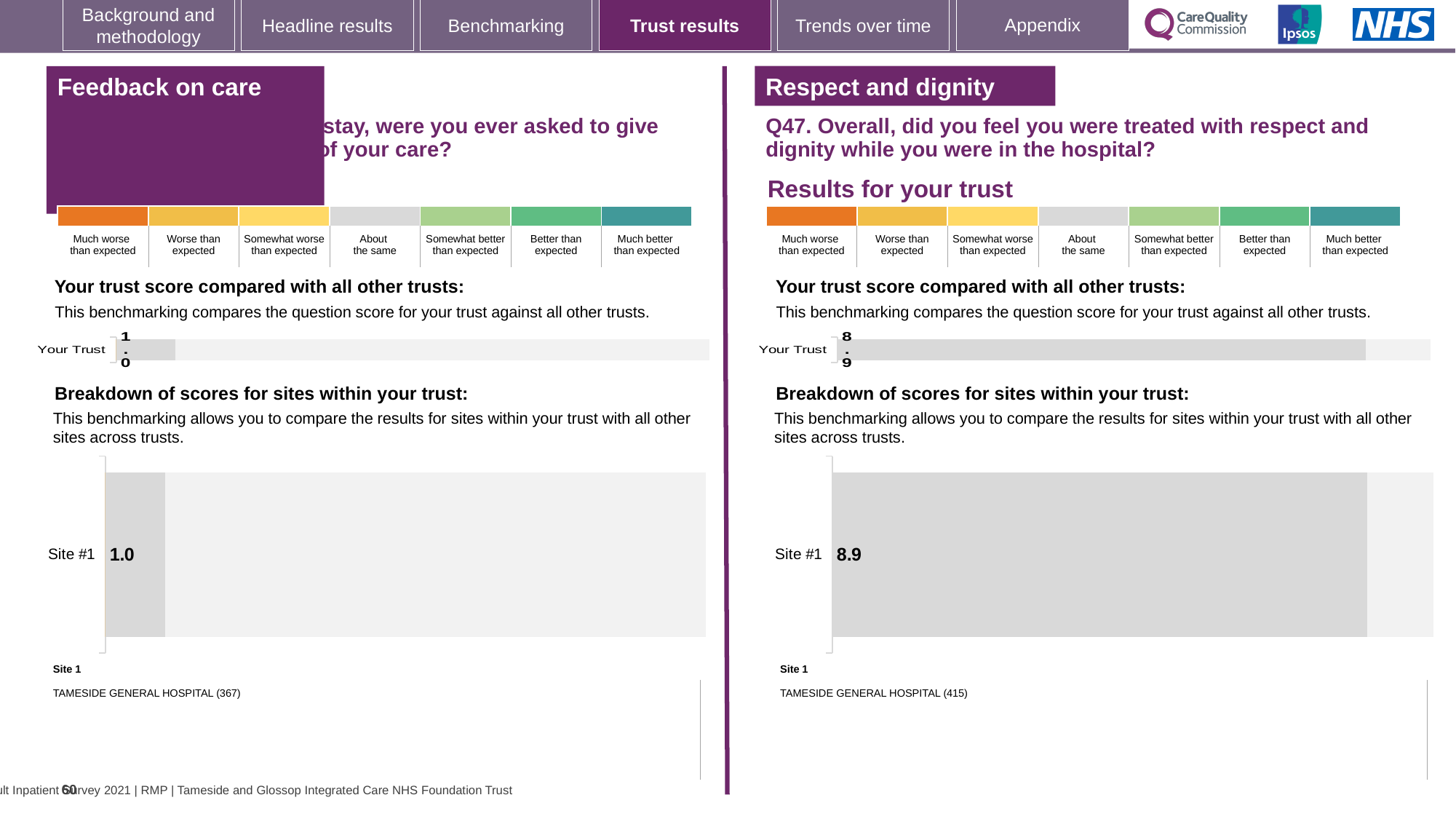
How many sites are shown in the 'Respect and dignity' site breakdown chart? 1 In the 'Feedback on care' section, what is the score shown for Your Trust in the trust comparison chart? 1.0 Which site is listed as Site 1 beneath the 'Respect and dignity' breakdown chart? TAMESIDE GENERAL HOSPITAL (415) In the 'Feedback on care' site breakdown chart, what is the score for Site #1? 1.0 Which is larger: the Your Trust score in the 'Feedback on care' chart or the Your Trust score in the 'Respect and dignity' chart? Respect and dignity How many sites are shown in the 'Feedback on care' site breakdown chart? 1 In the 'Respect and dignity' section, what is the score shown for Your Trust in the trust comparison chart? 8.9 In the 'Respect and dignity' site breakdown chart, what is the score for Site #1? 8.9 What is the difference between the Site #1 score in the 'Respect and dignity' breakdown chart and the Site #1 score in the 'Feedback on care' breakdown chart? 7.9 What type of chart is used to show the Site #1 score in the 'Respect and dignity' section? Bar chart Which site is listed as Site 1 beneath the 'Feedback on care' breakdown chart? TAMESIDE GENERAL HOSPITAL (367) What type of chart is used to show the Your Trust score in the 'Feedback on care' section? Bar chart